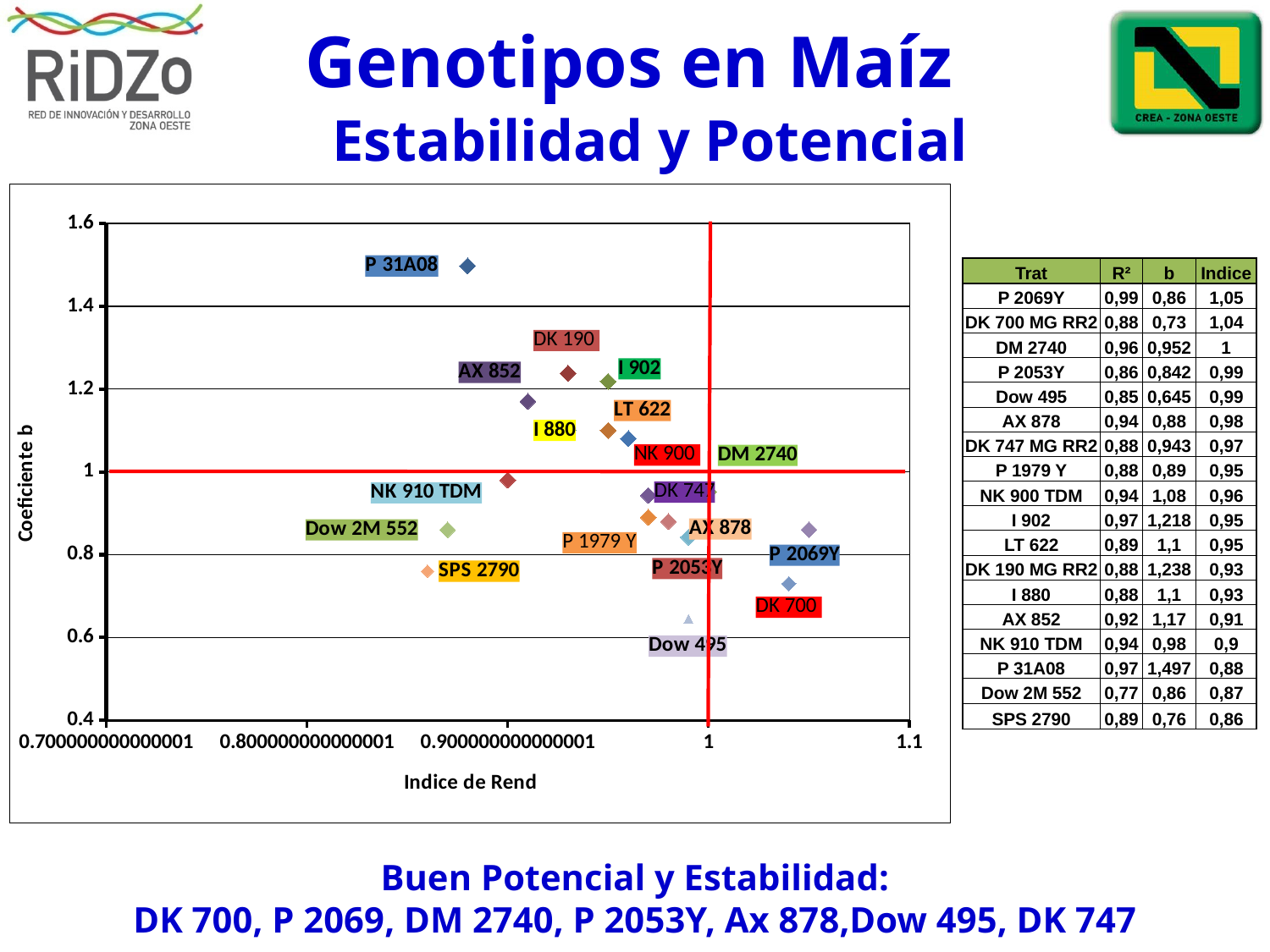
According to the table next to the chart, what is the b value for P 31A08? 1,497 What is the title of the y axis of the chart? Coeficiente b Which genotype has the highest Coeficiente b on the chart? P 31A08 What kind of chart is shown on the slide? scatter chart How many genotypes (points) are plotted on the chart? 18 Which genotype has the lowest Coeficiente b on the chart? Dow 495 Which genotype has the highest Indice de Rend on the chart? P 2069Y Which has a higher Coeficiente b, AX 852 or I 880? AX 852 Is the Coeficiente b for P 31A08 greater or less than 1.4? greater What is the title of the x axis of the chart? Indice de Rend Is the Coeficiente b for Dow 495 greater or less than 0.8? less Is the Indice de Rend for DK 700 greater or less than 1? greater